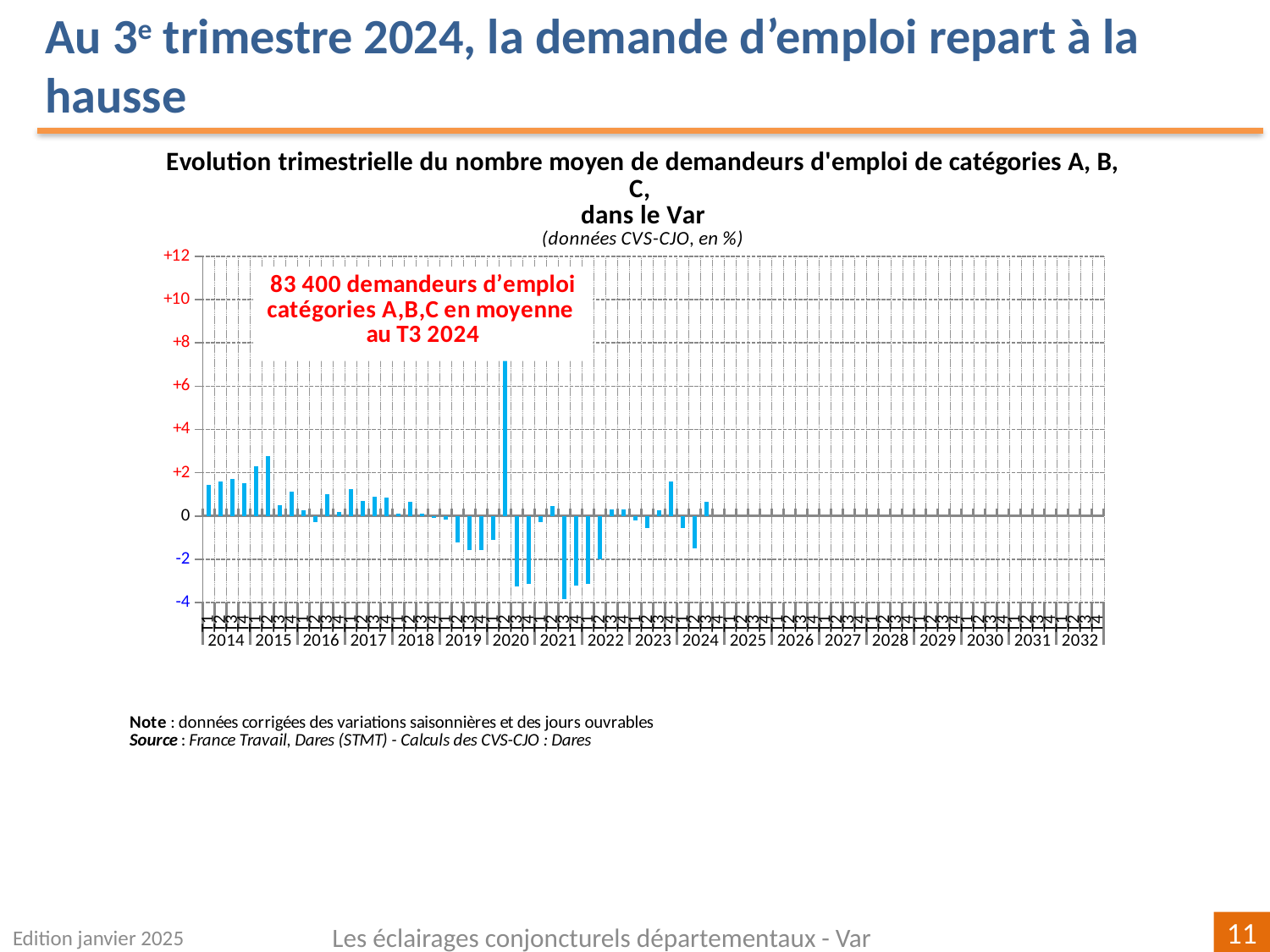
In which year does the tallest (highest) bar of the chart occur? 2020 What kind of chart is shown on the slide? bar chart Is the highest bar in 2015 greater or less than +2? greater Is the value for T2 2024 greater or less than 0? less According to the red annotation on the chart, how many demandeurs d'emploi catégories A,B,C were there on average in T3 2024? 83 400 How many years are labelled on the x axis of the chart? 19 Is the value of the tallest bar (in 2020) greater or less than +6? greater In what unit are the data of the chart expressed, according to the subtitle? en % In which year does the lowest (most negative) bar of the chart occur? 2021